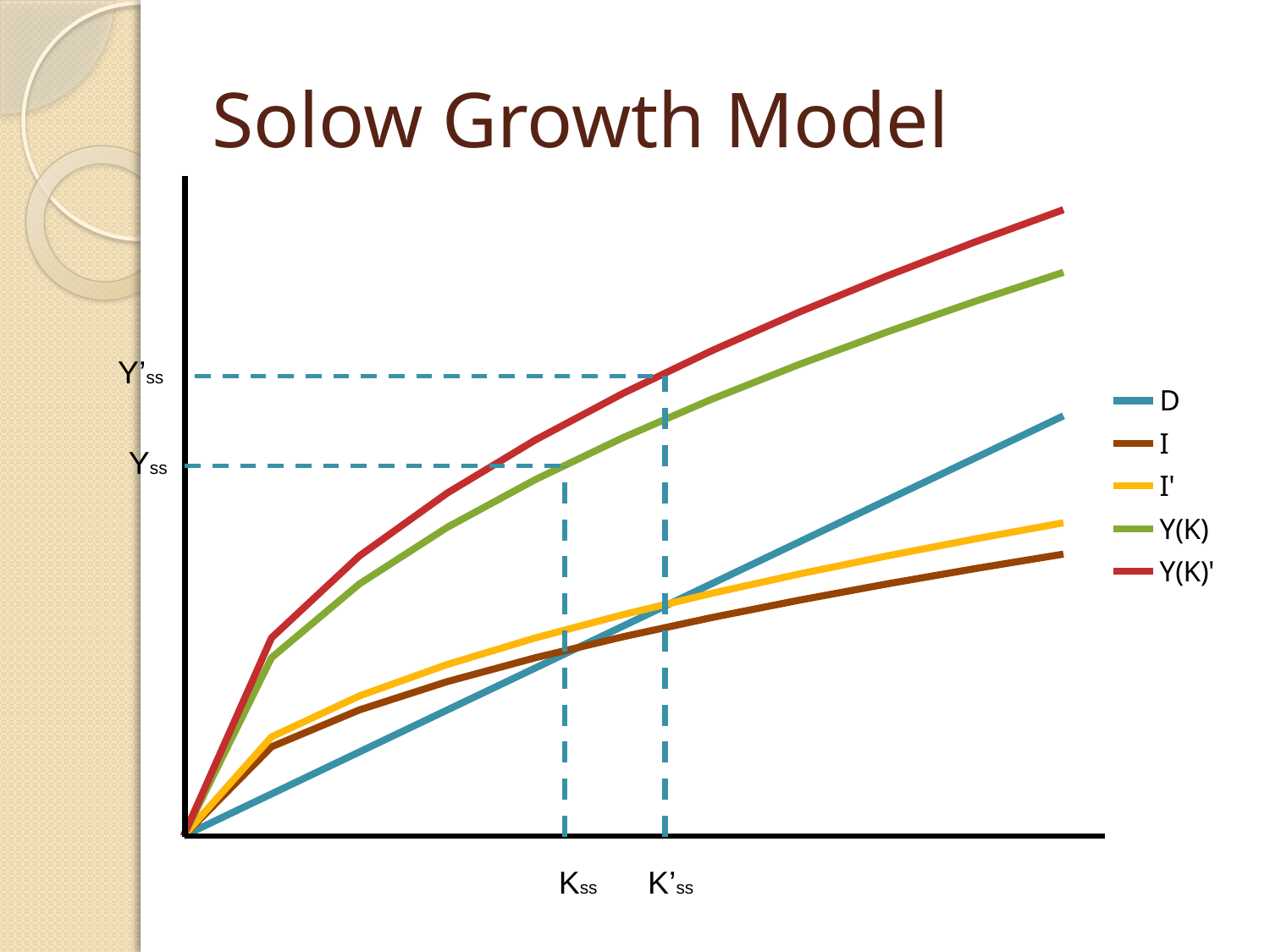
Which series is a straight line through the origin? D At the right end of the chart, which is higher, I or I'? I' How many series does the legend list? 5 At the right end of the chart, which is higher, D or I'? D What kind of chart is shown on the slide? line chart Which series is lowest at the right end of the chart? I Which series reaches the highest point at the right end of the chart? Y(K)' Do the values of the D series rise or fall as K increases along the x axis? rise Which series is plotted in red? Y(K)' Do the values of the Y(K) series rise or fall along the x axis? rise At the right end of the chart, which is higher, Y(K) or Y(K)'? Y(K)' What is the title of the slide containing the chart? Solow Growth Model